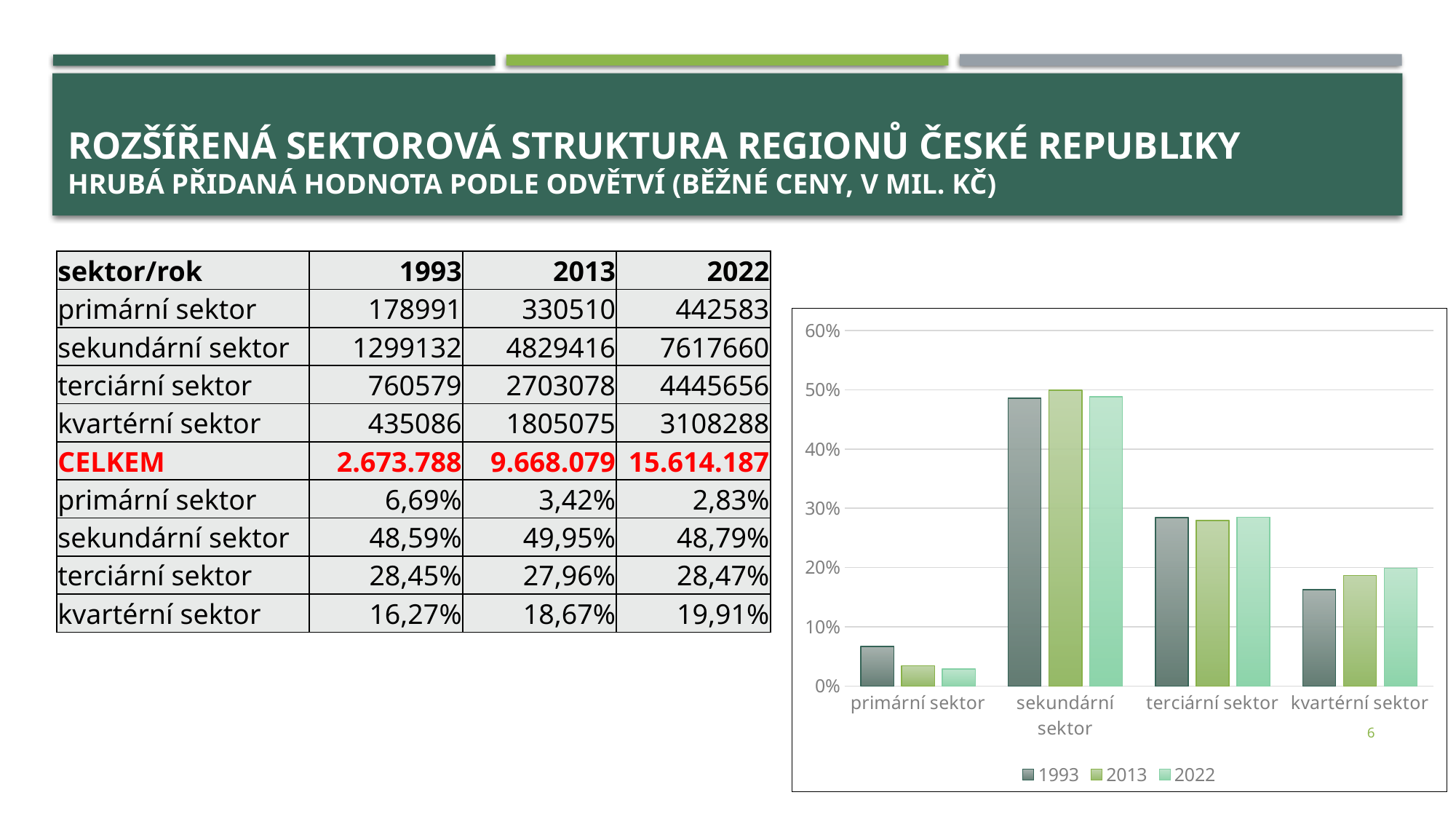
Is the 1993 value for primární sektor greater or less than 10%? less How many sector categories are shown on the x axis of the chart? 4 How many series does the chart legend list? 3 For kvartérní sektor, which is larger: the 1993 value or the 2022 value? 2022 Is the 1993 value for kvartérní sektor greater or less than 10%? greater What kind of chart is shown on the slide? bar chart Which sector has the lowest bars in the chart? primární sektor Do the values for primární sektor rise or fall from 1993 to 2022? fall Is the 1993 value for sekundární sektor greater or less than 40%? greater Which years are listed in the chart legend? 1993, 2013, 2022 Which sector has the highest bars in the chart? sekundární sektor